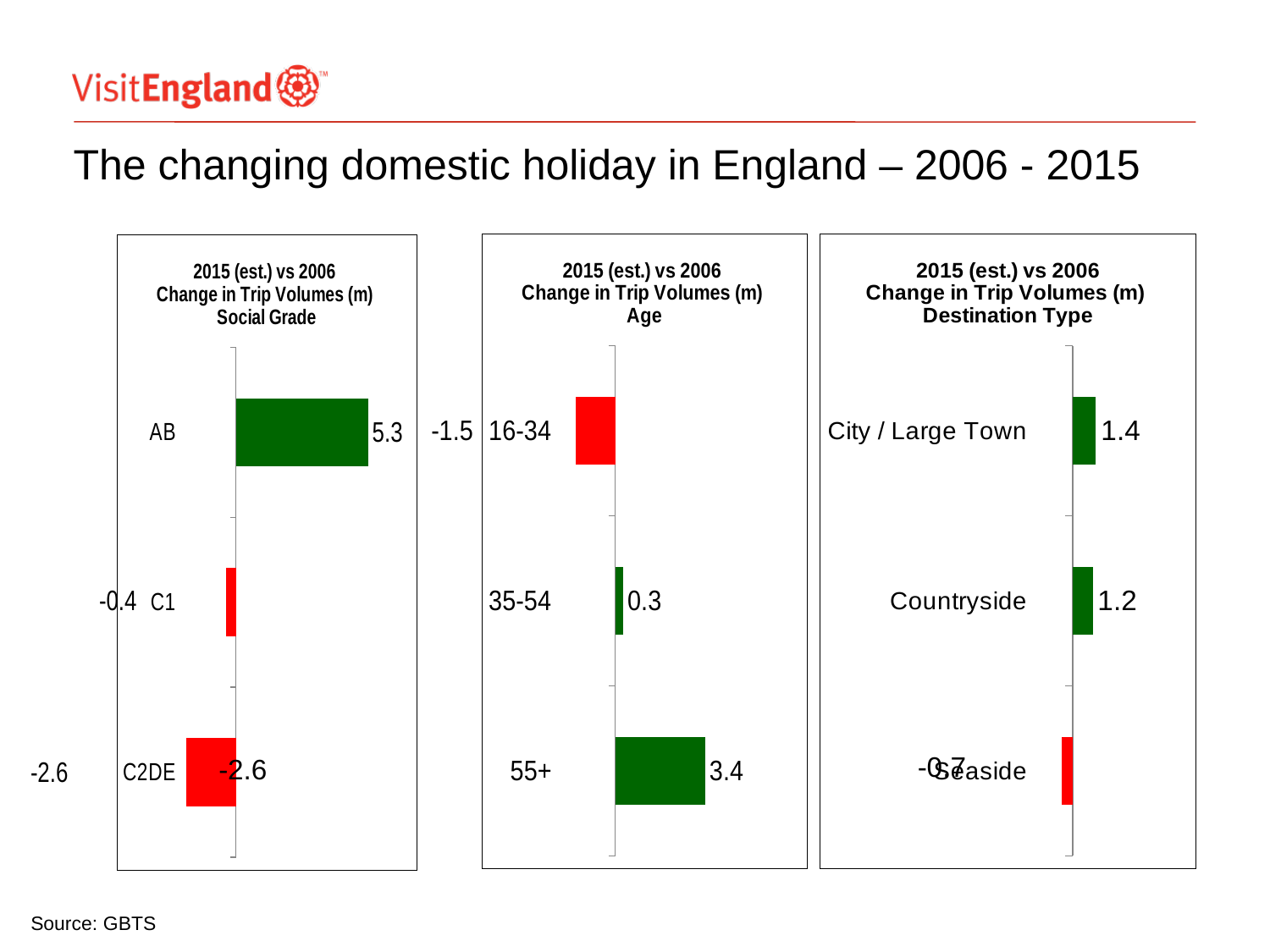
How many categories are shown in the Age chart? 3 In the Social Grade chart, what is the change in trip volumes for C2DE? -2.6 In the Age chart, what is the change in trip volumes for the 55+ age group? 3.4 What type of chart is the Social Grade chart? Bar chart In the Age chart, which age group has the lowest change in trip volumes? 16-34 In the Age chart, what is the difference between the change for 55+ and the change for 35-54? 3.1 In the Social Grade chart, what is the change in trip volumes for AB? 5.3 In the Social Grade chart, which social grade has the highest change in trip volumes? AB In the Destination Type chart, what is the change in trip volumes for Countryside? 1.2 In the Destination Type chart, which is larger, the change for City / Large Town or for Countryside? City / Large Town In the Age chart, what is the change in trip volumes for the 16-34 age group? -1.5 In the Social Grade chart, what is the change in trip volumes for C1? -0.4